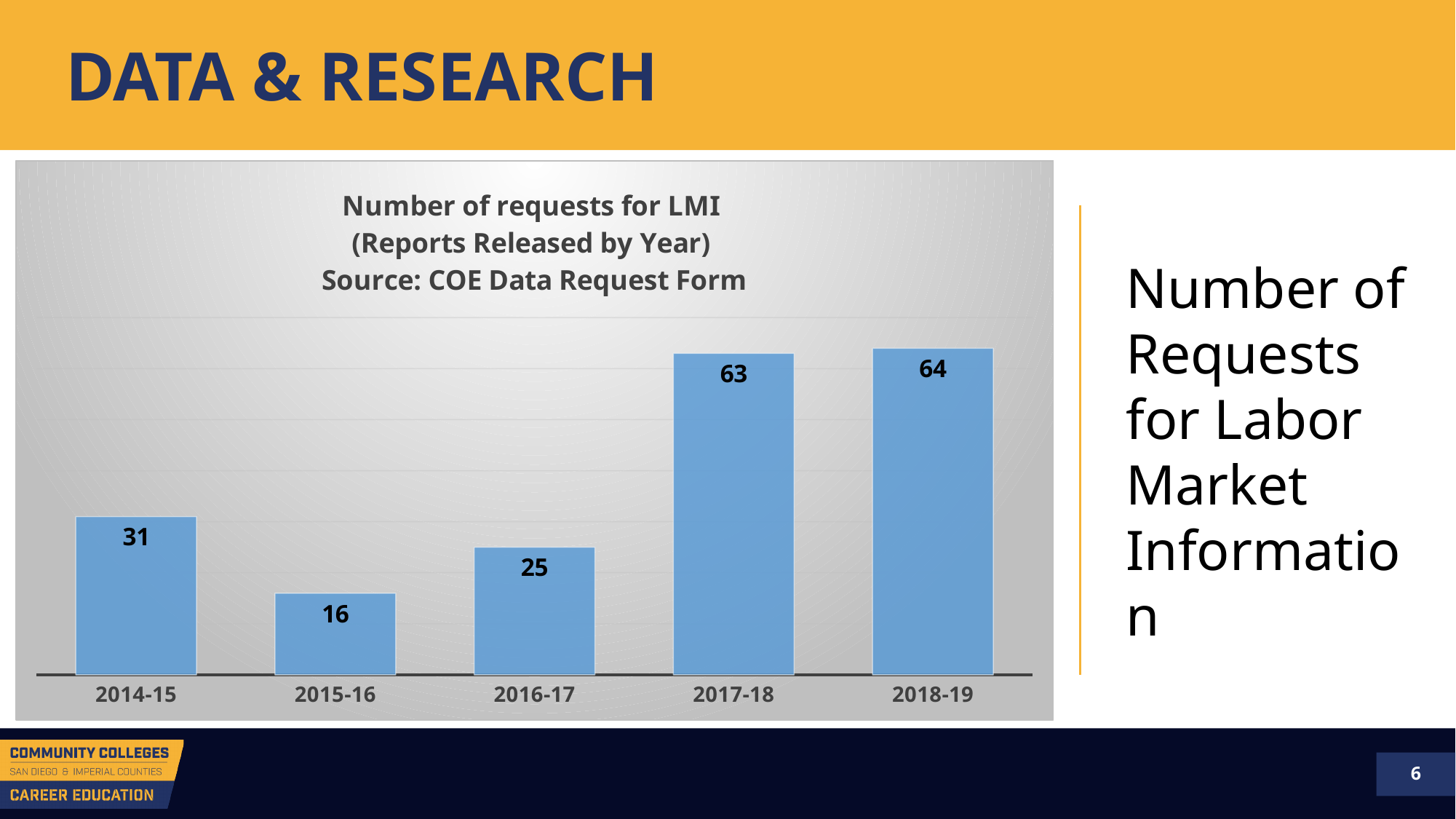
Which year had more requests for LMI, 2014-15 or 2016-17? 2014-15 Which year has the lowest number of requests for LMI? 2015-16 Which year has the highest number of requests for LMI? 2018-19 What is the difference in the number of requests between 2017-18 and 2016-17? 38 Do the number of requests rise or fall from 2016-17 to 2018-19? Rise What source is cited in the chart title? COE Data Request Form What is the difference in the number of requests between 2014-15 and 2015-16? 15 How many years are shown on the chart? 5 What kind of chart is shown on the slide? Bar chart What is the number of requests for LMI in 2015-16? 16 What is the number of requests for LMI in 2017-18? 63 What is the number of requests for LMI in 2014-15? 31